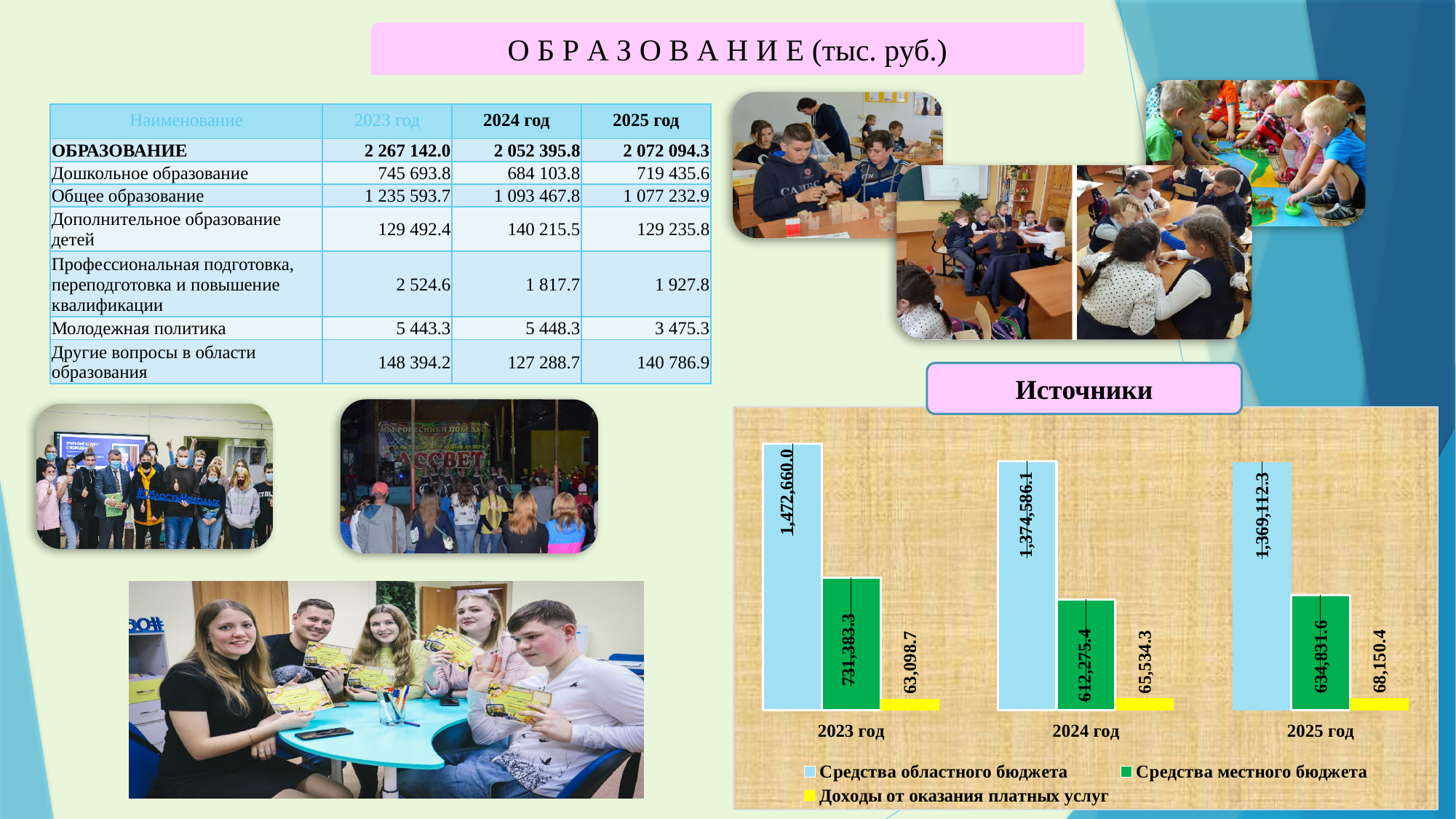
In the "Источники" chart, which year has the highest value for Средства областного бюджета? 2023 год How many years are shown on the x axis of the "Источники" chart? 3 In the "Источники" chart, what is the value of Доходы от оказания платных услуг for 2025 год? 68,150.4 In the "Источники" chart, what is the difference between Средства областного бюджета in 2023 год and 2024 год? 98,073.9 In the "Источники" chart, what is the difference between Доходы от оказания платных услуг in 2025 год and 2023 год? 5,051.7 How many series does the legend of the "Источники" chart list? 3 In the "Источники" chart, which is larger: Средства местного бюджета in 2024 год or in 2025 год? 2025 год In the "Источники" chart, what is the value of Средства местного бюджета for 2024 год? 612,275.4 In the "Источники" chart, do the values for Средства областного бюджета rise or fall from 2023 год to 2025 год? fall In the "Источники" chart, what is the value of Средства областного бюджета for 2023 год? 1,472,660.0 In the "Источники" chart, which year has the lowest value for Доходы от оказания платных услуг? 2023 год What kind of chart is shown under the title "Источники"? bar chart